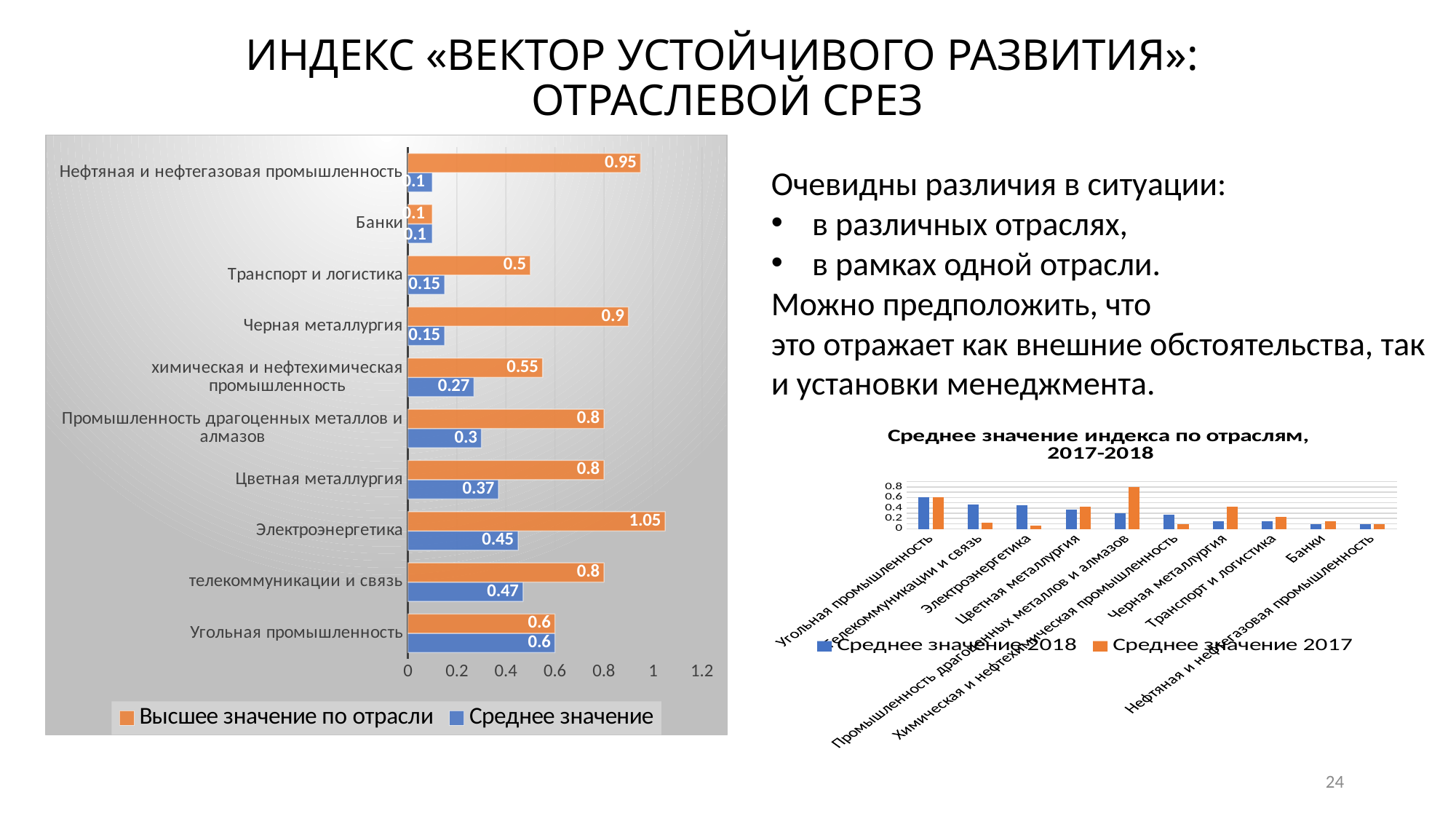
In the left chart, what is the 'Среднее значение' for химическая и нефтехимическая промышленность? 0.27 In the left chart, what is the difference between the 'Высшее значение по отрасли' and the 'Среднее значение' for Нефтяная и нефтегазовая промышленность? 0.85 How many industries are shown in the left chart? 10 In the chart 'Среднее значение индекса по отраслям, 2017-2018', is the 'Среднее значение 2017' for Промышленность драгоценных металлов и алмазов greater or less than 0.6? greater How many series does the legend of the left chart list? 2 In the left chart, what is the value of 'Высшее значение по отрасли' for Электроэнергетика? 1.05 What is the title of the chart on the right? Среднее значение индекса по отраслям, 2017-2018 In the left chart, which industry has the lowest 'Высшее значение по отрасли'? Банки In the left chart, which is larger: the 'Среднее значение' for Цветная металлургия or for Промышленность драгоценных металлов и алмазов? Цветная металлургия In the left chart, what is the 'Среднее значение' for телекоммуникации и связь? 0.47 In the left chart, which industry has the highest 'Высшее значение по отрасли'? Электроэнергетика In the left chart, which industry has the highest 'Среднее значение'? Угольная промышленность